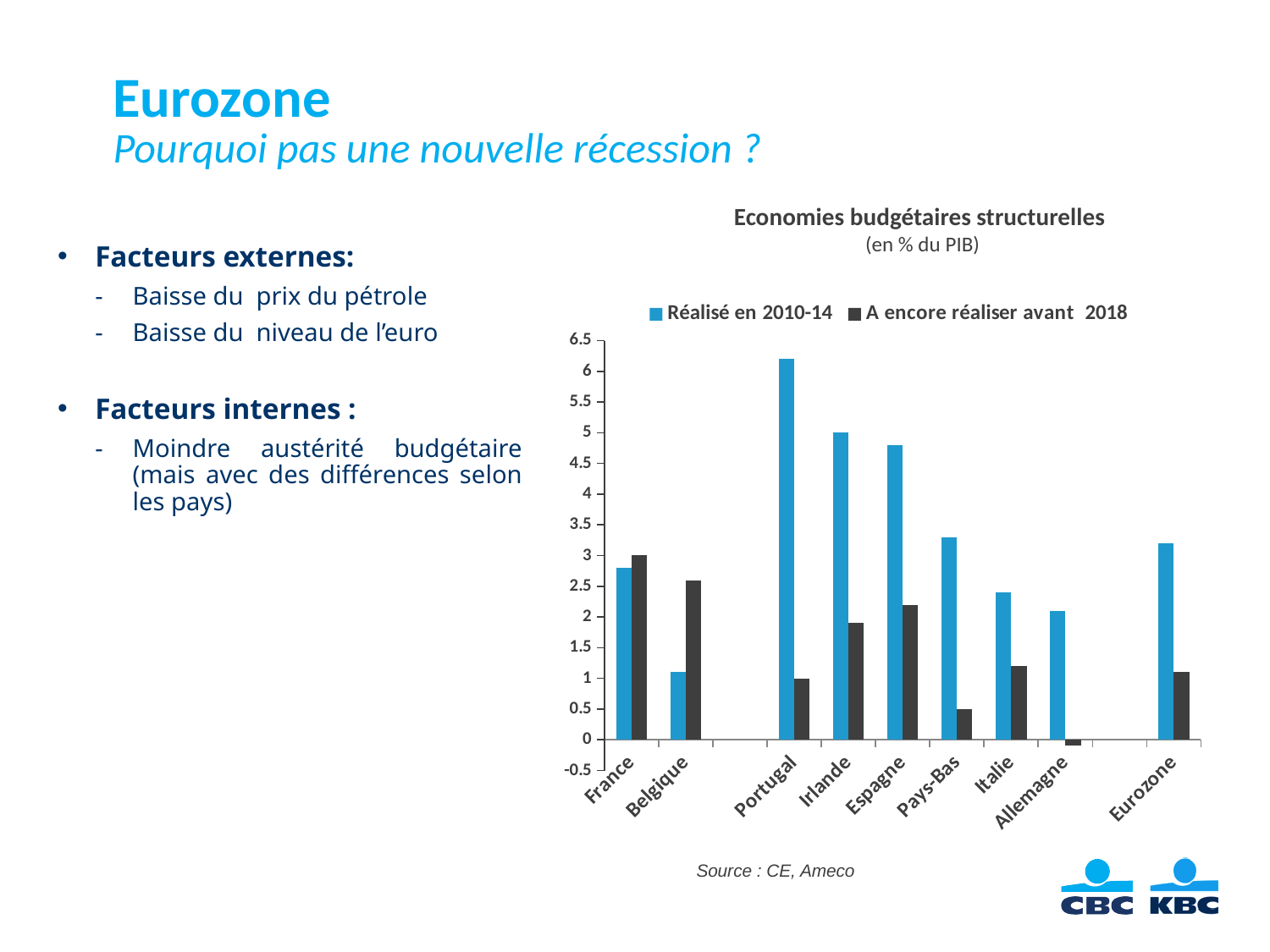
Which country has the lowest value for 'Réalisé en 2010-14'? Belgique Is the 'Réalisé en 2010-14' value for Portugal greater or less than 6? greater What kind of chart is shown on the slide? bar chart Which country has the highest value for 'Réalisé en 2010-14'? Portugal Which is larger for Espagne: 'Réalisé en 2010-14' or 'A encore réaliser avant 2018'? Réalisé en 2010-14 What is the title of the chart? Economies budgétaires structurelles Is the 'A encore réaliser avant 2018' value for Belgique greater or less than 2? greater How many series does the legend list? 2 Which country has the highest value for 'A encore réaliser avant 2018'? France Which country has the lowest value for 'A encore réaliser avant 2018'? Allemagne How many countries/regions are shown on the x axis of the chart? 9 Is the 'Réalisé en 2010-14' value for Allemagne greater or less than 2.5? less